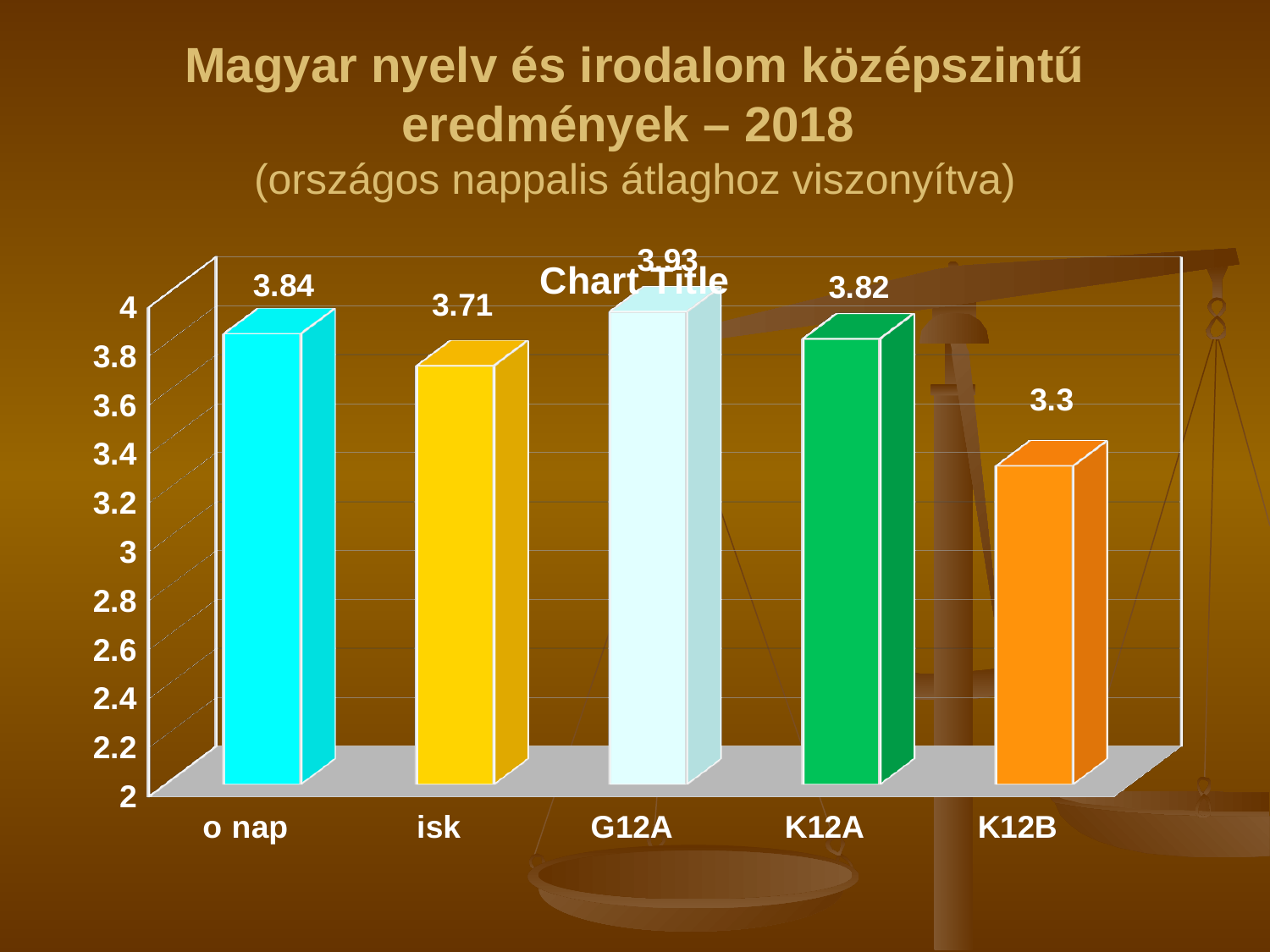
What is the value for isk? 3.71 Which category has the lowest value? K12B What kind of chart is shown on the slide? bar chart How many categories are shown on the x axis? 5 What is the value for K12B? 3.3 Is the value for isk greater or less than 3.6? greater What is the value for o nap? 3.84 What title is printed inside the chart area? Chart Title What is the difference between the values for G12A and K12B? 0.63 Which is larger, the value for K12A or the value for K12B? K12A Which category has the highest value? G12A What is the difference between the values for o nap and isk? 0.13